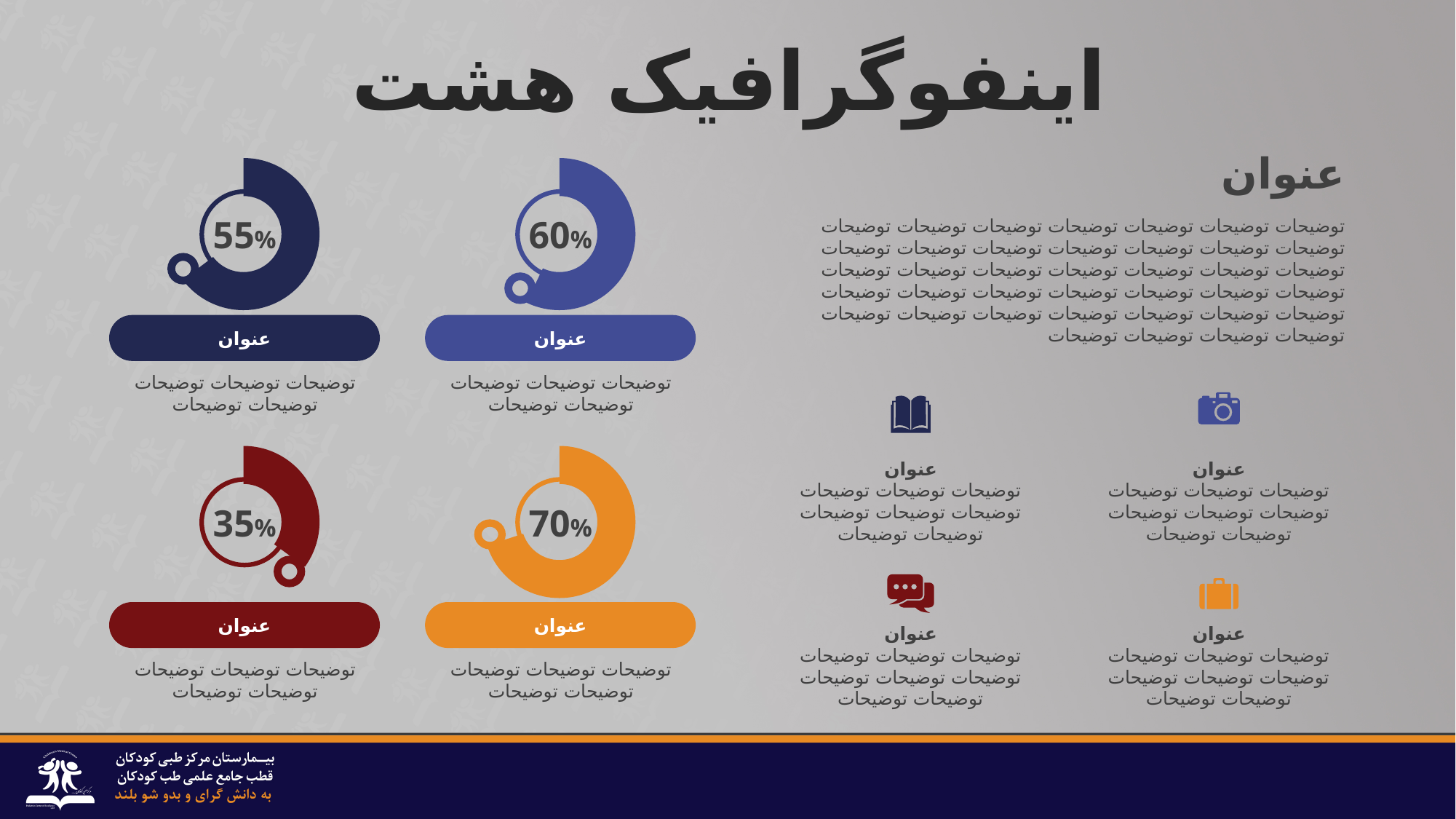
What value is shown in the dark navy donut chart at the top left of the slide? 55% What is the difference between the value in the blue donut chart and the value in the dark navy donut chart? 5% Which is larger, the value in the dark navy donut chart or the value in the dark red donut chart? The dark navy chart (55%) What is the difference between the value in the orange donut chart and the value in the dark red donut chart? 35% What value is shown in the orange donut chart at the bottom, second from the left? 70% What kind of chart is used to display the percentages on the left side of the slide? Donut chart What colour is the donut chart that shows 60%? Blue How many donut charts are shown on the slide? 4 What value is shown in the dark red donut chart at the bottom left of the slide? 35% Which of the four donut charts shows the highest percentage? The orange chart (70%) Which of the four donut charts shows the lowest percentage? The dark red chart (35%) What value is shown in the blue donut chart at the top, second from the left? 60%